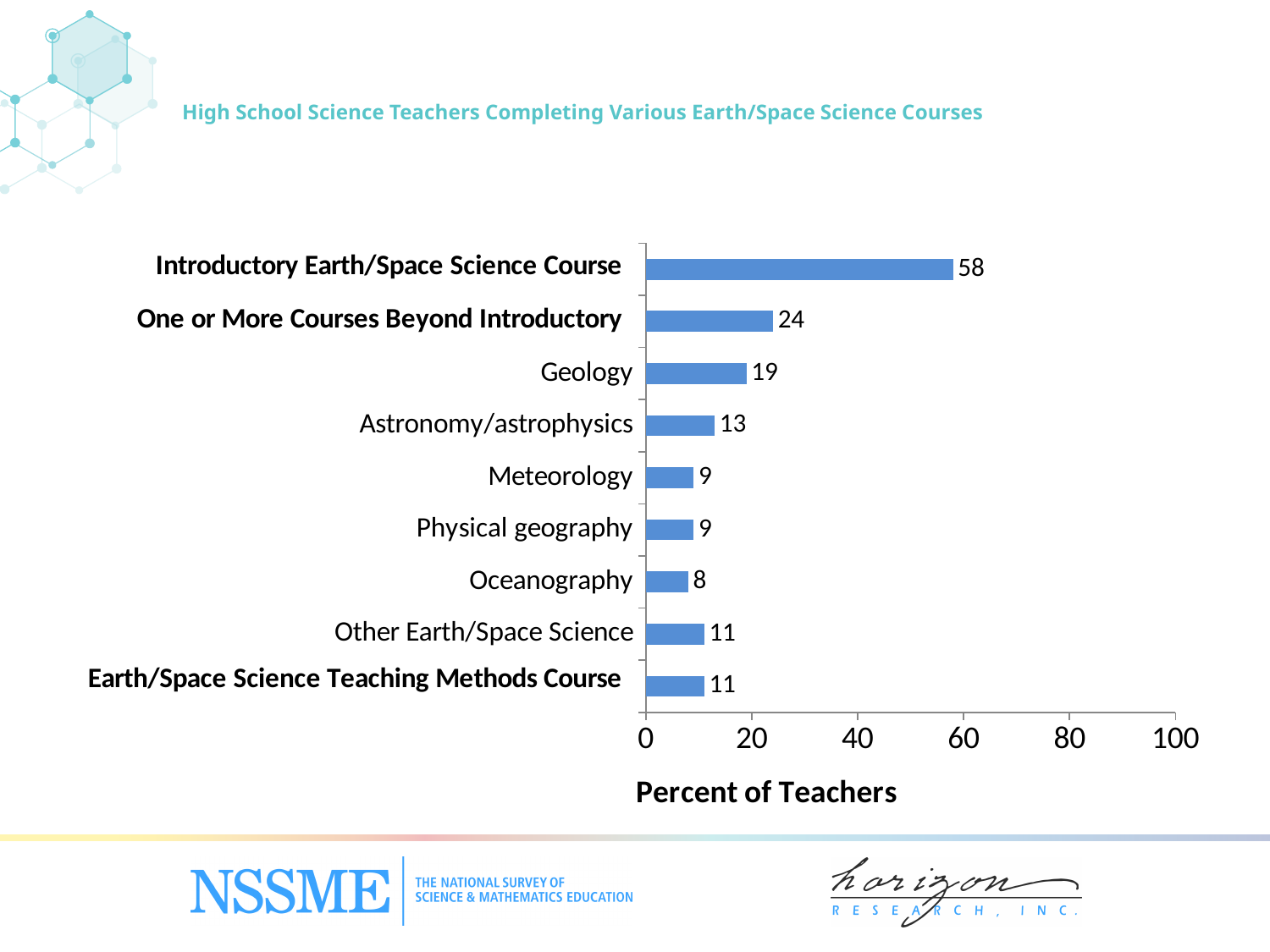
What is the value for Earth/Space Science Teaching Methods Course? 11 Which category has the highest value? Introductory Earth/Space Science Course Which category has the lowest value? Oceanography What is the label of the horizontal axis? Percent of Teachers Is the value for One or More Courses Beyond Introductory greater or less than 20? greater How many categories are shown in the chart? 9 What is the value for Astronomy/astrophysics? 13 What is the difference between the values for Introductory Earth/Space Science Course and One or More Courses Beyond Introductory? 34 What is the value for Geology? 19 What percent of teachers completed an Introductory Earth/Space Science Course? 58 Which is larger, the value for Geology or the value for Astronomy/astrophysics? Geology What kind of chart is shown on the slide? Bar chart